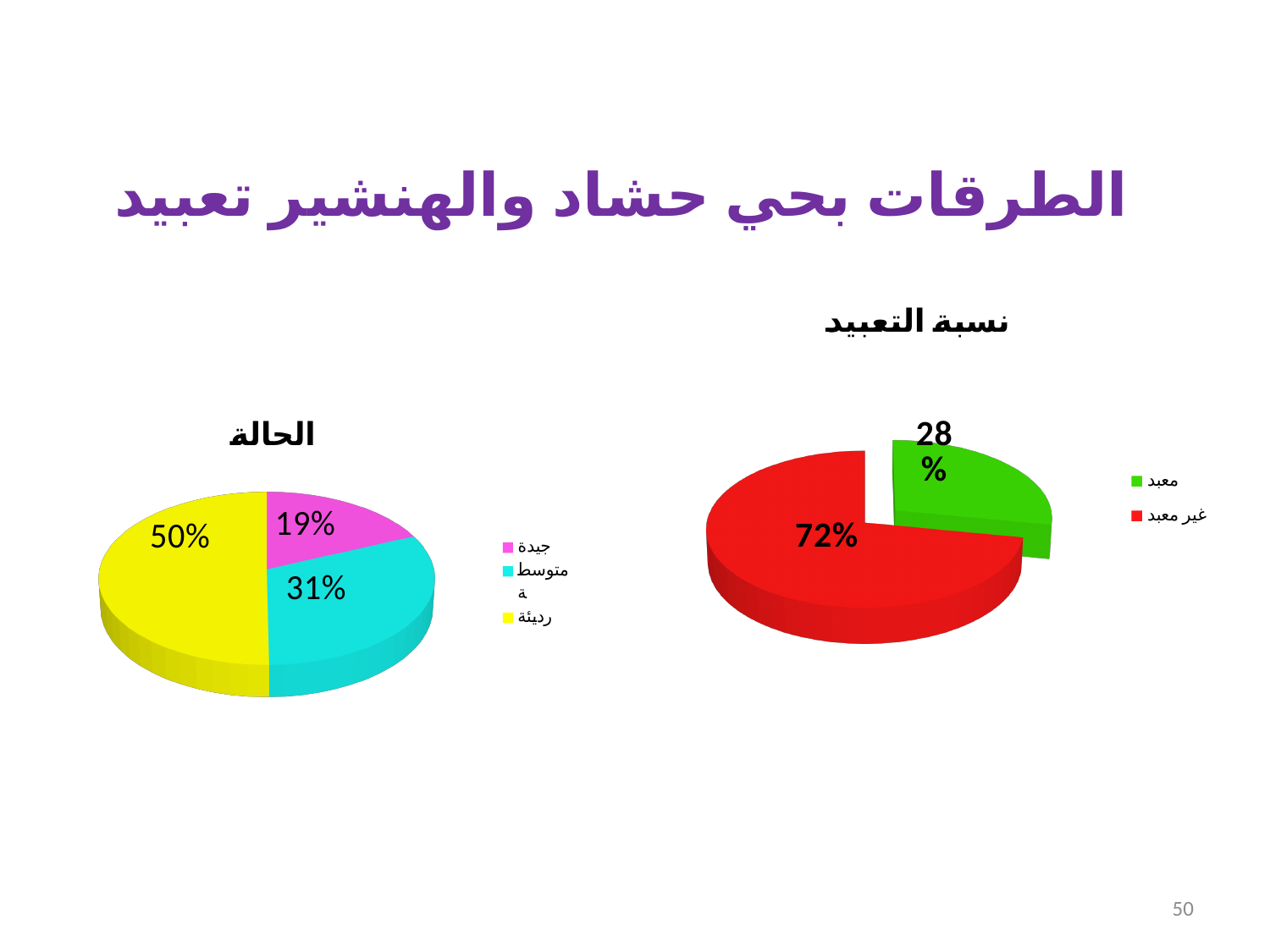
In the chart titled "نسبة التعبيد", what percentage is shown for "غير معبد"? 72% What type of chart is the chart titled "نسبة التعبيد"? Pie chart In the chart titled "الحالة", which category has the smallest share? جيدة In the chart titled "الحالة", which category has the largest share? رديئة In the chart titled "الحالة", what percentage is shown for "رديئة"? 50% In the chart titled "نسبة التعبيد", what is the difference in percentage points between "غير معبد" and "معبد"? 44 In the chart titled "الحالة", what percentage is shown for "جيدة"? 19% In the chart titled "الحالة", how many categories does the legend list? 3 In the chart titled "الحالة", what percentage is shown for "متوسطة"? 31% In the chart titled "نسبة التعبيد", what percentage is shown for "معبد"? 28% In the chart titled "نسبة التعبيد", what colour is the slice for "معبد"? Green In the chart titled "نسبة التعبيد", which category has the larger share? غير معبد